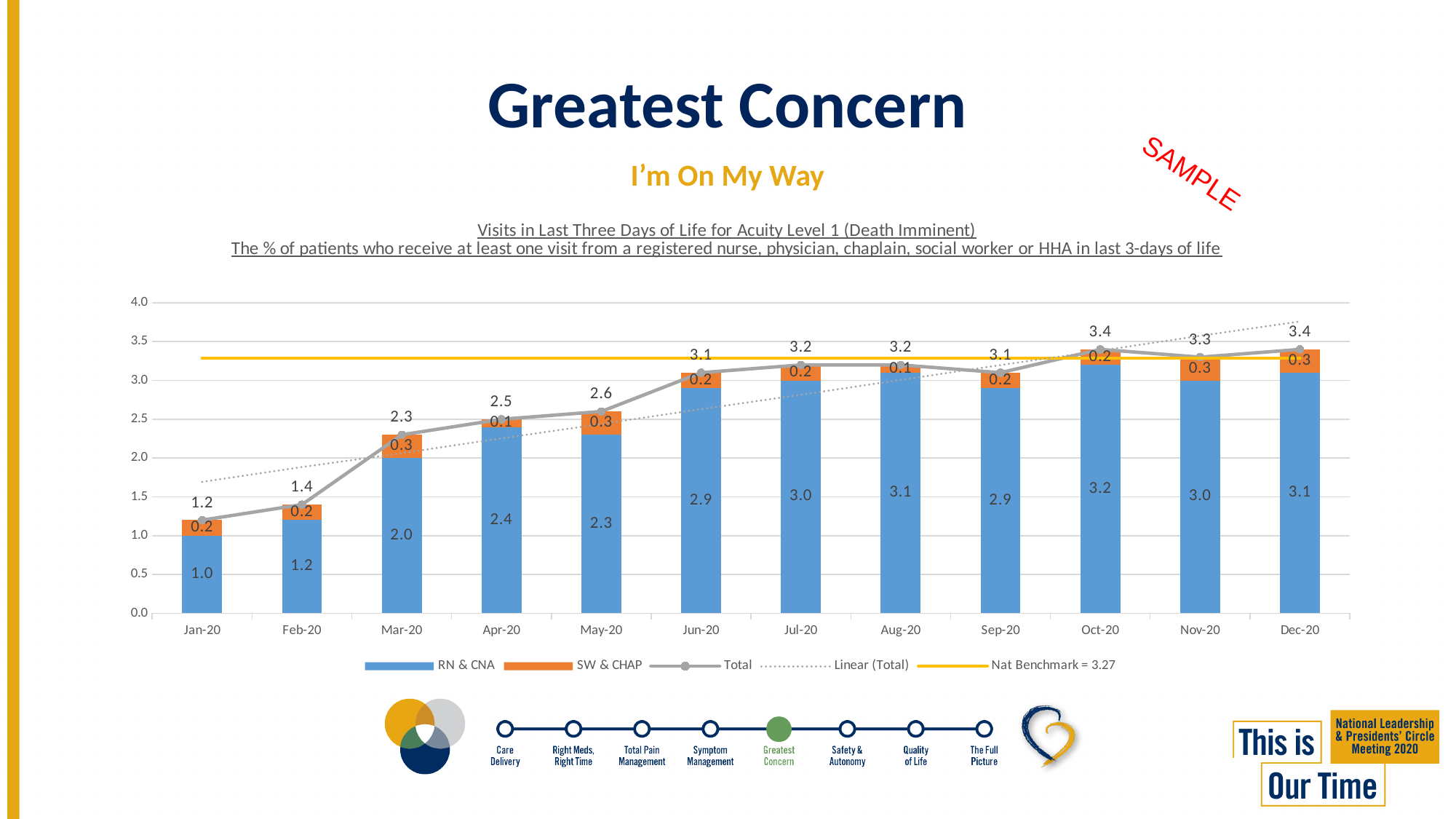
Which month has the highest RN & CNA value? Oct-20 Which month has the lowest Total value? Jan-20 Does the Total value generally rise or fall from Jan-20 to Dec-20? Rise How many entries does the legend list? 5 Which month has the larger RN & CNA value, Apr-20 or May-20? Apr-20 What is the RN & CNA value for Jun-20? 2.9 How many months are shown on the x axis? 12 What is the Total value for Oct-20? 3.4 What is the difference between the Total value for Dec-20 and the Total value for Jan-20? 2.2 What is the value of the Nat Benchmark shown in the legend? 3.27 What kind of chart is used to show the RN & CNA and SW & CHAP values? Stacked bar chart What is the SW & CHAP value for Mar-20? 0.3